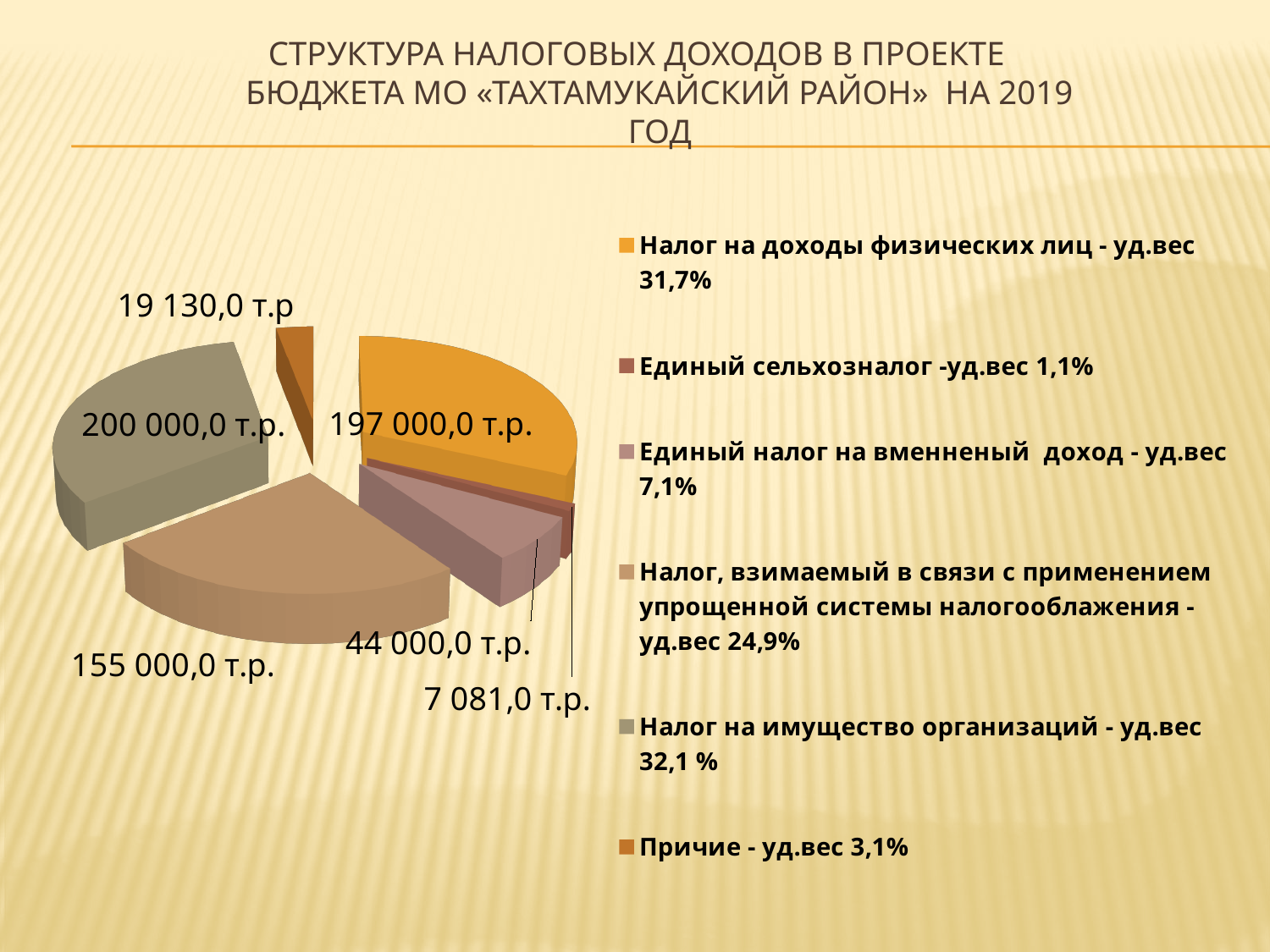
What is the value shown for Единый сельхозналог? 7 081,0 т.р. What is the value shown for Прочие? 19 130,0 т.р What share of the pie does Налог, взимаемый в связи с применением упрощенной системы налогооблажения have? 24,9% How many slices does the pie chart have? 6 Which category has the smallest share of the pie? Единый сельхозналог What kind of chart is shown on the slide? pie chart What is the difference between the values for Налог на имущество организаций and Налог на доходы физических лиц? 3 000,0 т.р. What is the value shown for Единый налог на вменненый доход? 44 000,0 т.р. What is the value shown for Налог на доходы физических лиц? 197 000,0 т.р. What is the value shown for Налог на имущество организаций? 200 000,0 т.р. Which category has the largest share of the pie? Налог на имущество организаций Which is larger: the value for Единый налог на вменненый доход or the value for Прочие? Единый налог на вменненый доход